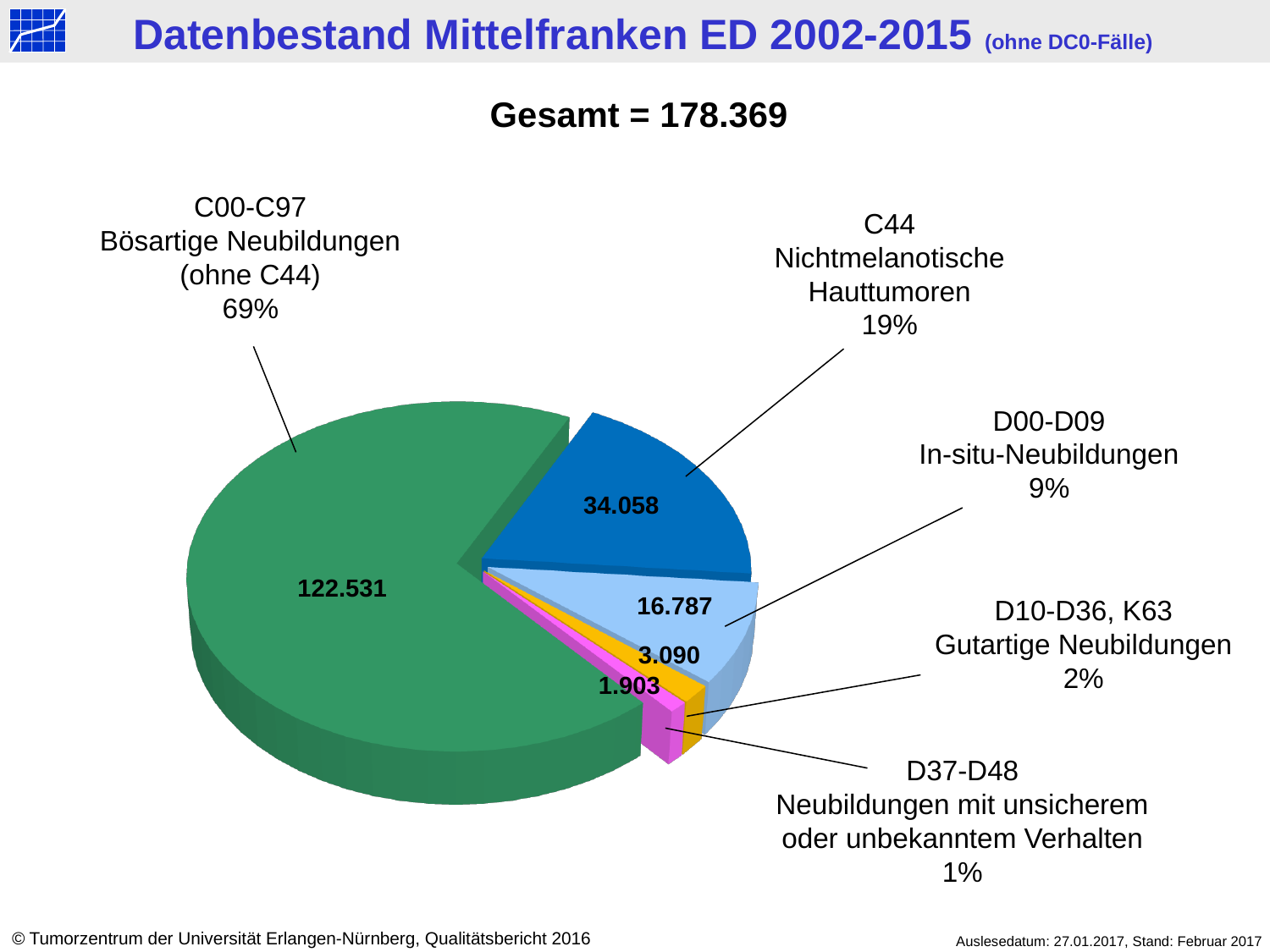
Which category has the smallest slice of the pie? D37-D48 Neubildungen mit unsicherem oder unbekanntem Verhalten What is the value for C44 Nichtmelanotische Hauttumoren? 34.058 What share of the pie does D10-D36, K63 Gutartige Neubildungen represent? 2% What total (Gesamt) is stated above the pie chart? 178.369 What kind of chart is shown on the slide? pie chart What share of the pie does C44 Nichtmelanotische Hauttumoren represent? 19% What is the value for C00-C97 Bösartige Neubildungen (ohne C44)? 122.531 What is the value for D37-D48 Neubildungen mit unsicherem oder unbekanntem Verhalten? 1.903 Which is larger, the value for C44 Nichtmelanotische Hauttumoren or the value for D00-D09 In-situ-Neubildungen? C44 Nichtmelanotische Hauttumoren How many slices does the pie chart have? 5 Which category has the largest slice of the pie? C00-C97 Bösartige Neubildungen (ohne C44) What is the value for D00-D09 In-situ-Neubildungen? 16.787